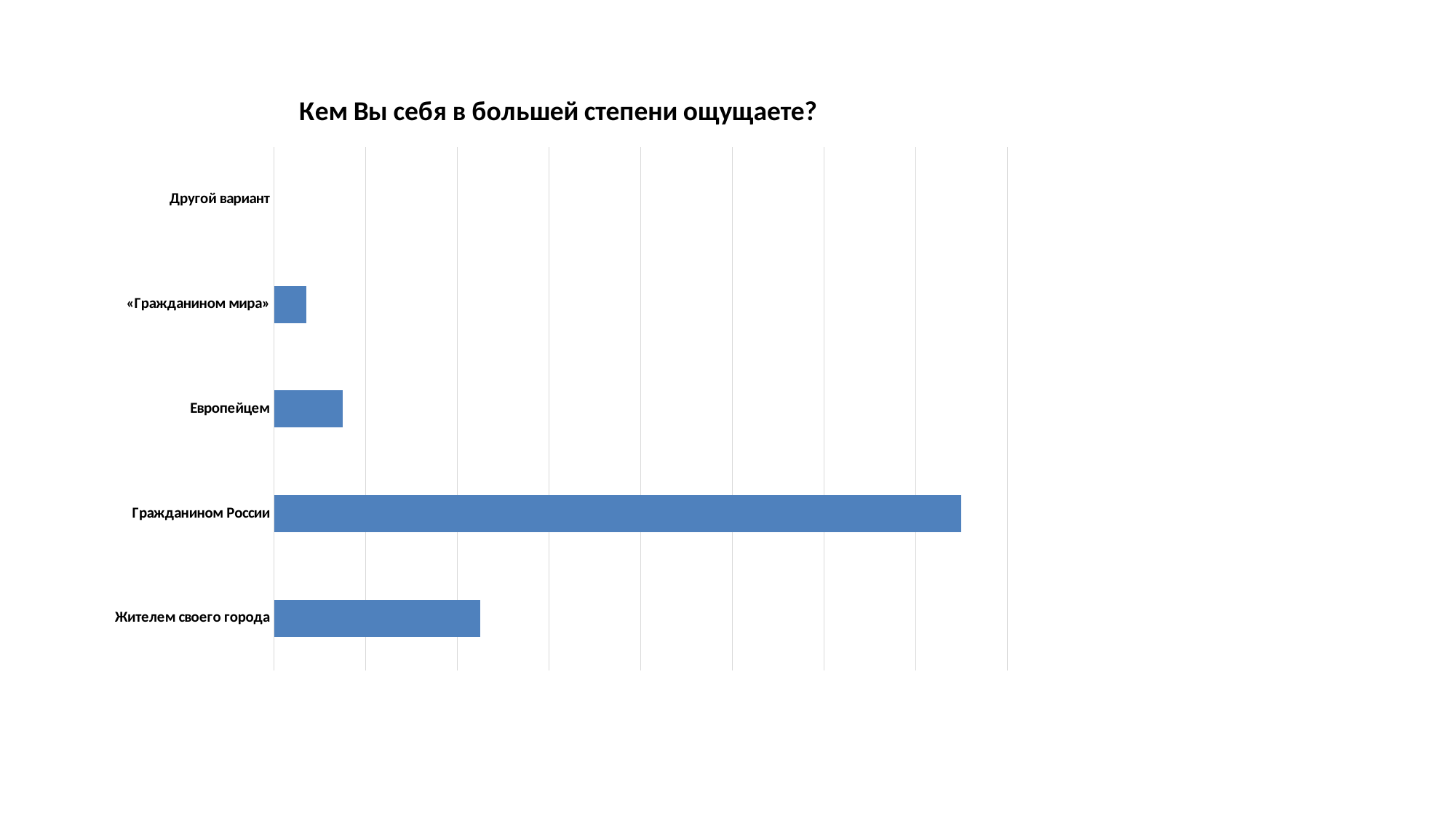
What colour are the bars in the chart? Blue What kind of chart is shown on the slide? Bar chart Which category has the second-highest value? Жителем своего города How many categories are shown on the chart? 5 What is the title of the chart? Кем Вы себя в большей степени ощущаете? Which category has the highest value? Гражданином России Which is larger, the value for Европейцем or the value for «Гражданином мира»? Европейцем Which is larger, the value for Жителем своего города or the value for Европейцем? Жителем своего города Which is larger, the value for Гражданином России or the value for Жителем своего города? Гражданином России